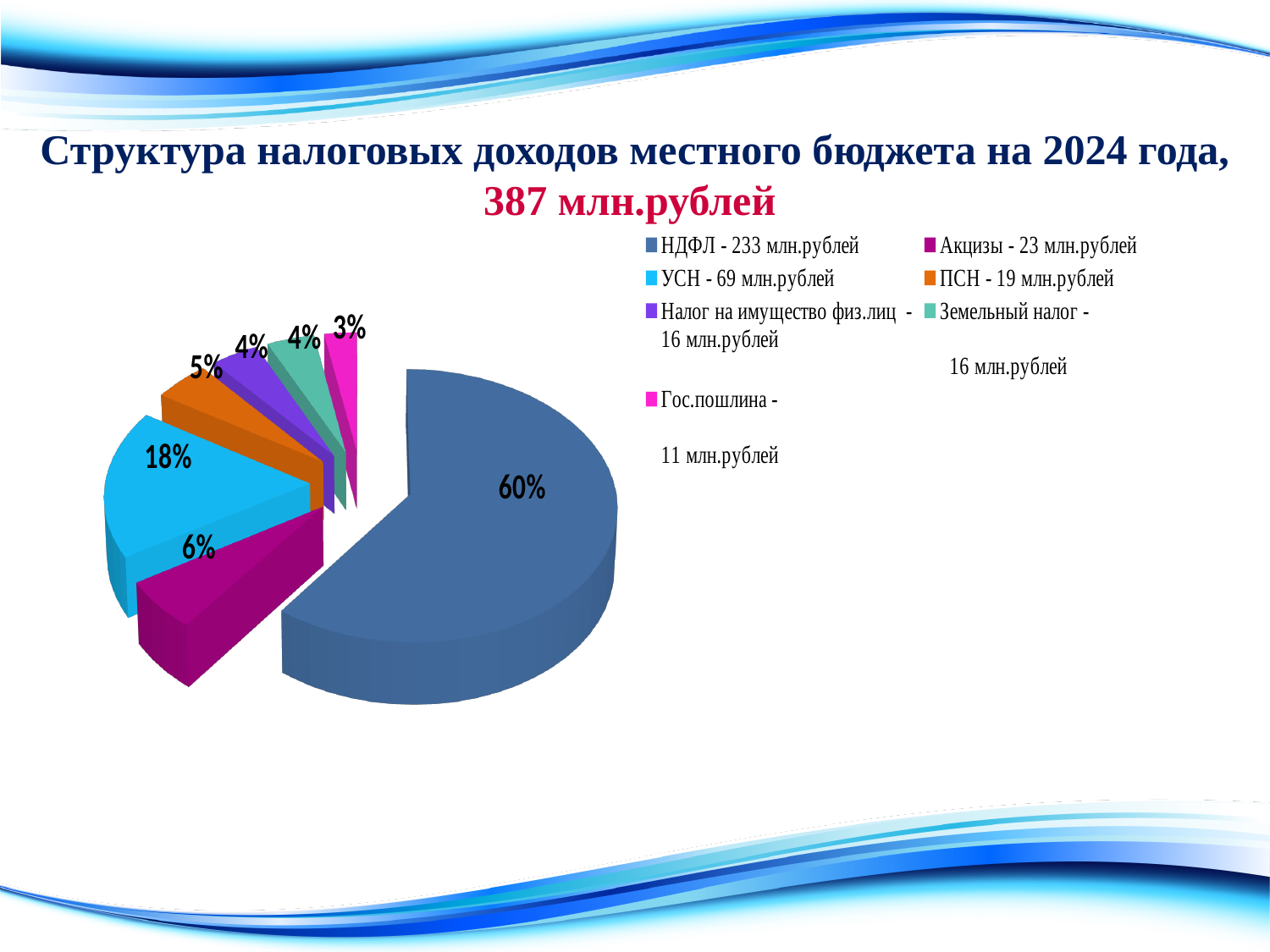
What share of the pie does Гос.пошлина have? 3% According to the legend, how many million rubles does НДФЛ amount to? 233 млн.рублей What share of the pie does Акцизы have? 6% Which category has the largest share of the pie? НДФЛ What kind of chart is shown on the slide? pie chart How many slices does the pie chart have? 7 What share of the pie does УСН have? 18% Which has a larger share, УСН or Акцизы? УСН What total amount is stated in the chart title? 387 млн.рублей Which category has the smallest share of the pie? Гос.пошлина What is the difference in percentage points between the НДФЛ share and the УСН share? 42